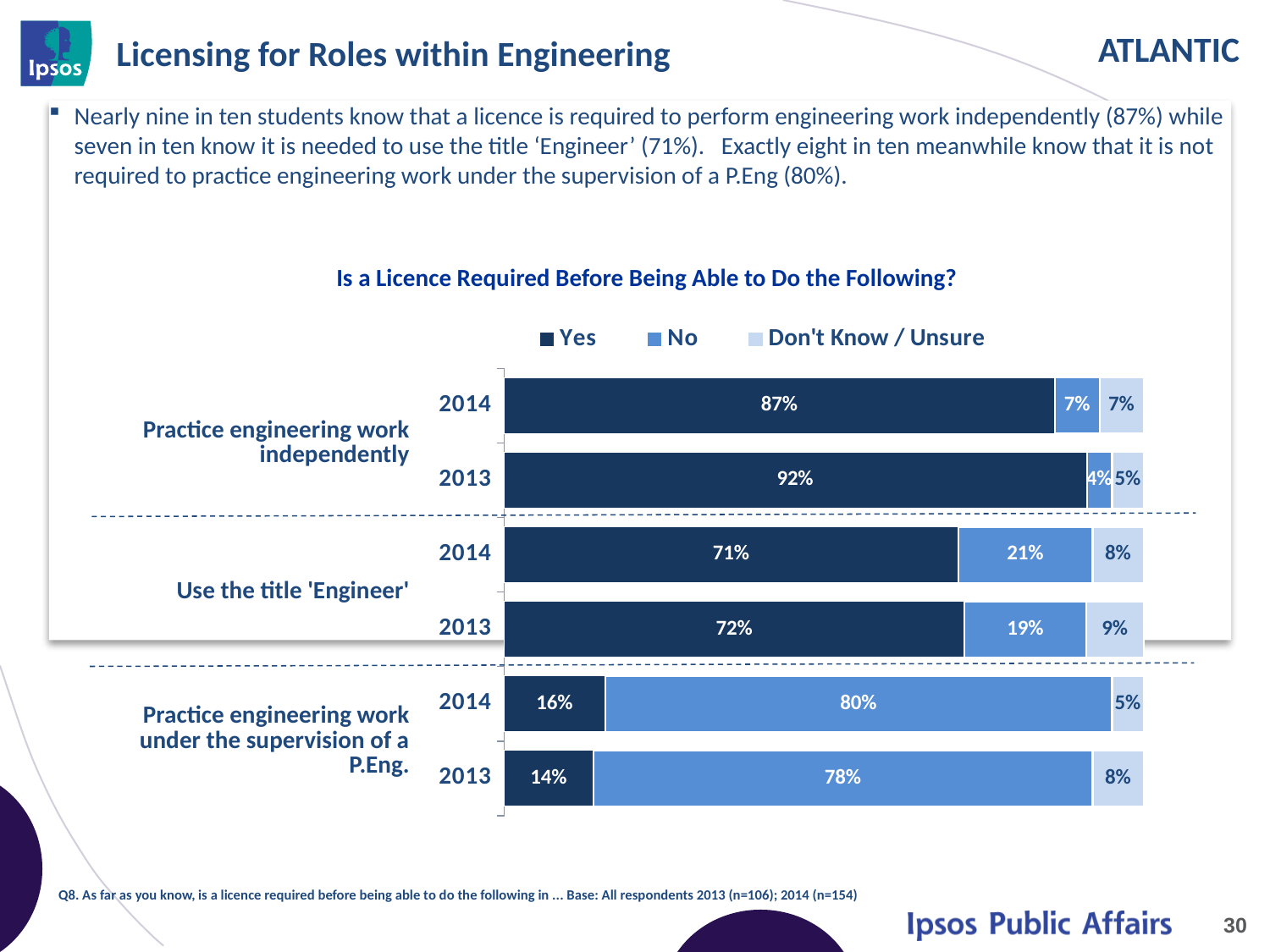
What percentage answered 'Yes' for 'Practice engineering work independently' in 2014? 87% Which is larger: the 'No' percentage for 'Use the title 'Engineer'' in 2014 or in 2013? 2014 What is the title of the chart? Is a Licence Required Before Being Able to Do the Following? What kind of chart is shown on the slide? Stacked bar chart What percentage answered 'No' for 'Use the title 'Engineer'' in 2014? 21% How many bars are plotted in the chart? 6 Which bar has the lowest 'Yes' percentage? Practice engineering work under the supervision of a P.Eng., 2013 What percentage answered 'Don't Know / Unsure' for 'Use the title 'Engineer'' in 2013? 9% How many series does the legend list? 3 What is the difference between the 'Yes' percentages for 'Practice engineering work independently' in 2013 and 2014? 5% What percentage answered 'No' for 'Practice engineering work under the supervision of a P.Eng.' in 2013? 78% Which bar has the highest 'Yes' percentage? Practice engineering work independently, 2013